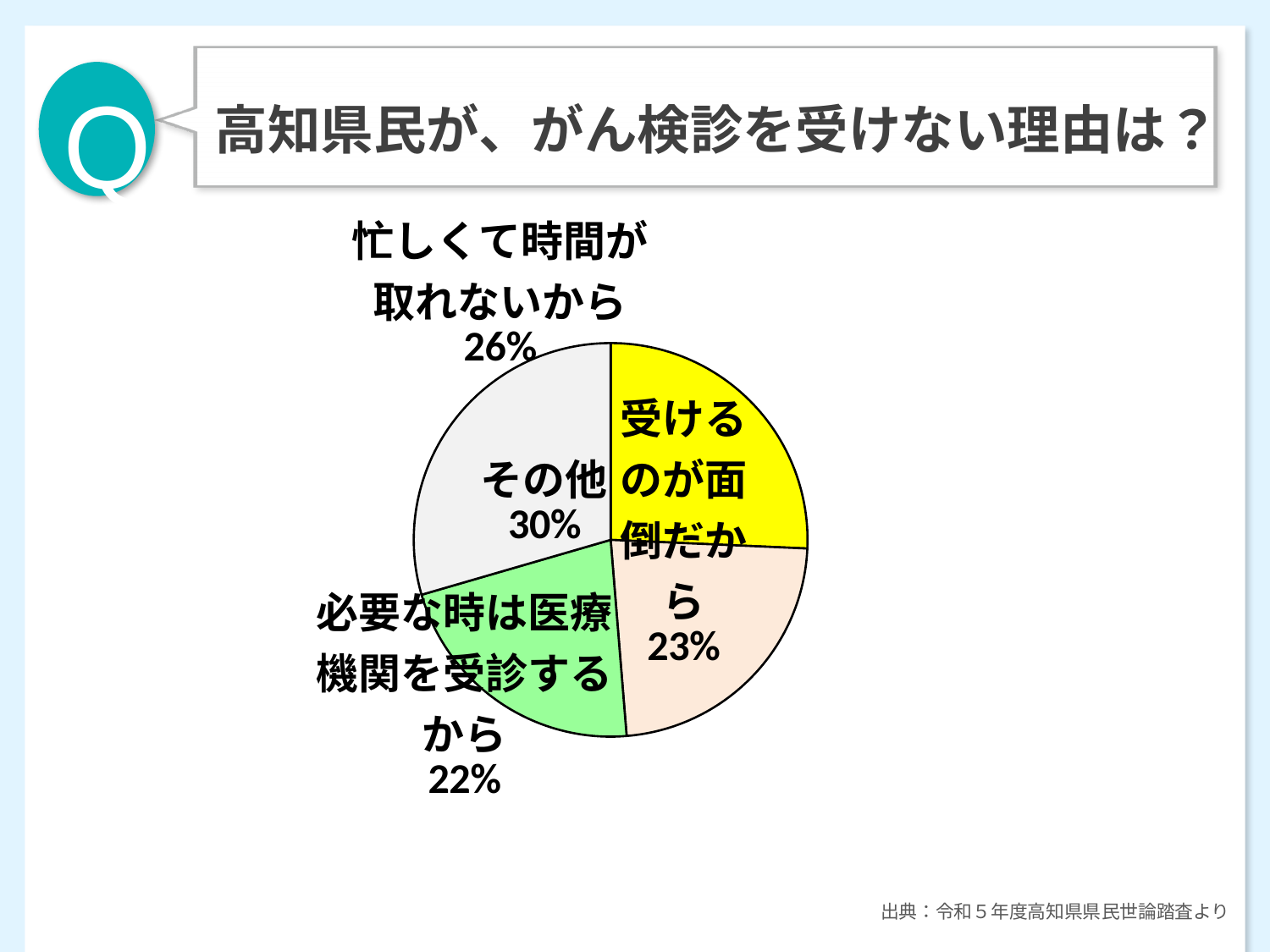
What is the difference in percentage points between その他 and 忙しくて時間が取れないから? 4 percentage points Which is larger: 忙しくて時間が取れないから or 受けるのが面倒だから? 忙しくて時間が取れないから What is the difference in percentage points between 忙しくて時間が取れないから and 必要な時は医療機関を受診するから? 4 percentage points What percentage of the pie chart is labelled その他? 30% How many slices does the pie chart have? 4 What percentage is shown for 忙しくて時間が取れないから? 26% What percentage is shown for 受けるのが面倒だから? 23% Which slice of the pie chart is the largest? その他 What colour is the slice for 受けるのが面倒だから? Yellow What question is posed in the title of the slide? 高知県民が、がん検診を受けない理由は？ What percentage is shown for 必要な時は医療機関を受診するから? 22% What kind of chart is shown on the slide? Pie chart